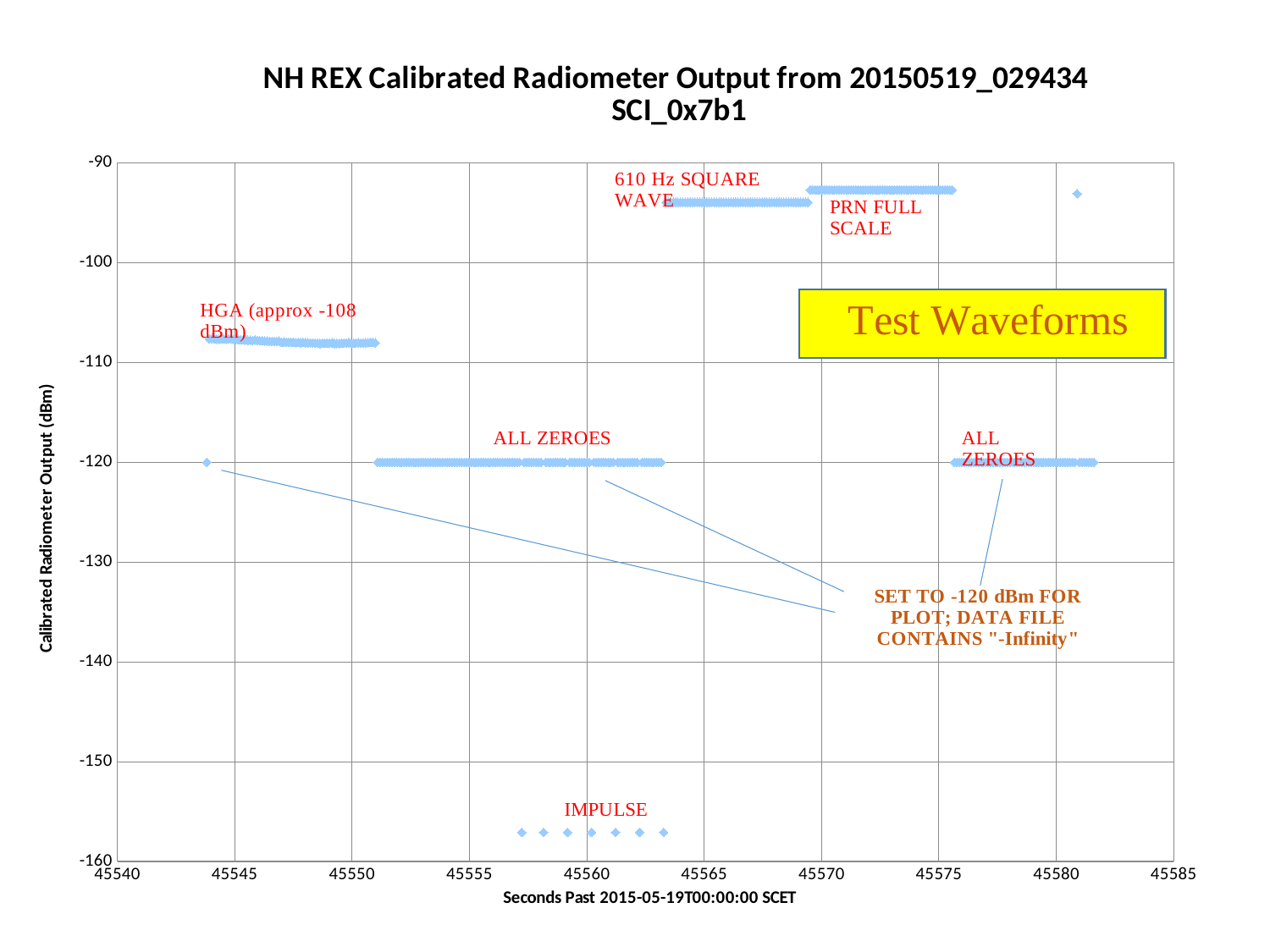
Is the value of the HGA segment greater or less than -100? less Which has the larger value, the HGA segment or the IMPULSE segment? HGA Is the value of the HGA segment greater or less than -110? greater Which labelled segment has the lowest radiometer output? IMPULSE What kind of chart is shown on the slide? scatter chart What is the title of the y axis? Calibrated Radiometer Output (dBm) According to the annotation, what does the data file contain for the points plotted at -120 dBm? "-Infinity" Which has the larger value, the 610 Hz SQUARE WAVE segment or the HGA segment? 610 Hz SQUARE WAVE Is the value of the PRN FULL SCALE segment greater or less than -100? greater What is the plotted value (in dBm) of the segments labelled ALL ZEROES? -120